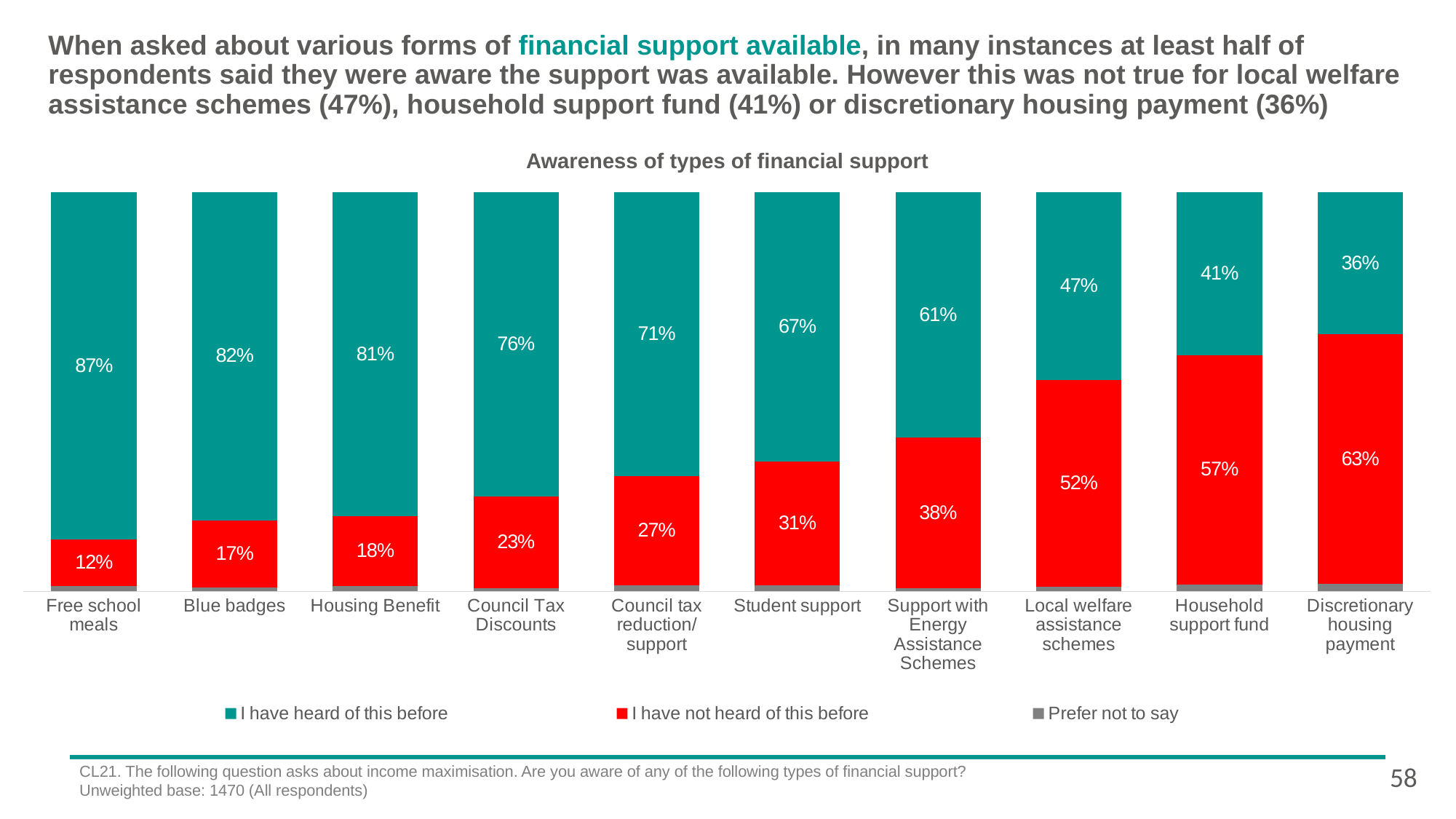
What percentage of respondents said they had not heard of Household support fund before? 57% What kind of chart is shown on the slide? Stacked bar chart What is the difference between the 'I have heard of this before' percentages for Blue badges and Council Tax Discounts? 6% Which type of financial support has the highest 'I have heard of this before' percentage? Free school meals What is the title of the chart? Awareness of types of financial support Which has a higher 'I have not heard of this before' percentage, Student support or Local welfare assistance schemes? Local welfare assistance schemes Do the 'I have heard of this before' values rise or fall moving from left to right along the x axis? Fall How many series does the legend list? 3 What is the 'I have heard of this before' value for Support with Energy Assistance Schemes? 61% What percentage of respondents said they had heard of Free school meals before? 87% How many types of financial support are shown on the x axis? 10 Which type of financial support has the lowest 'I have heard of this before' percentage? Discretionary housing payment